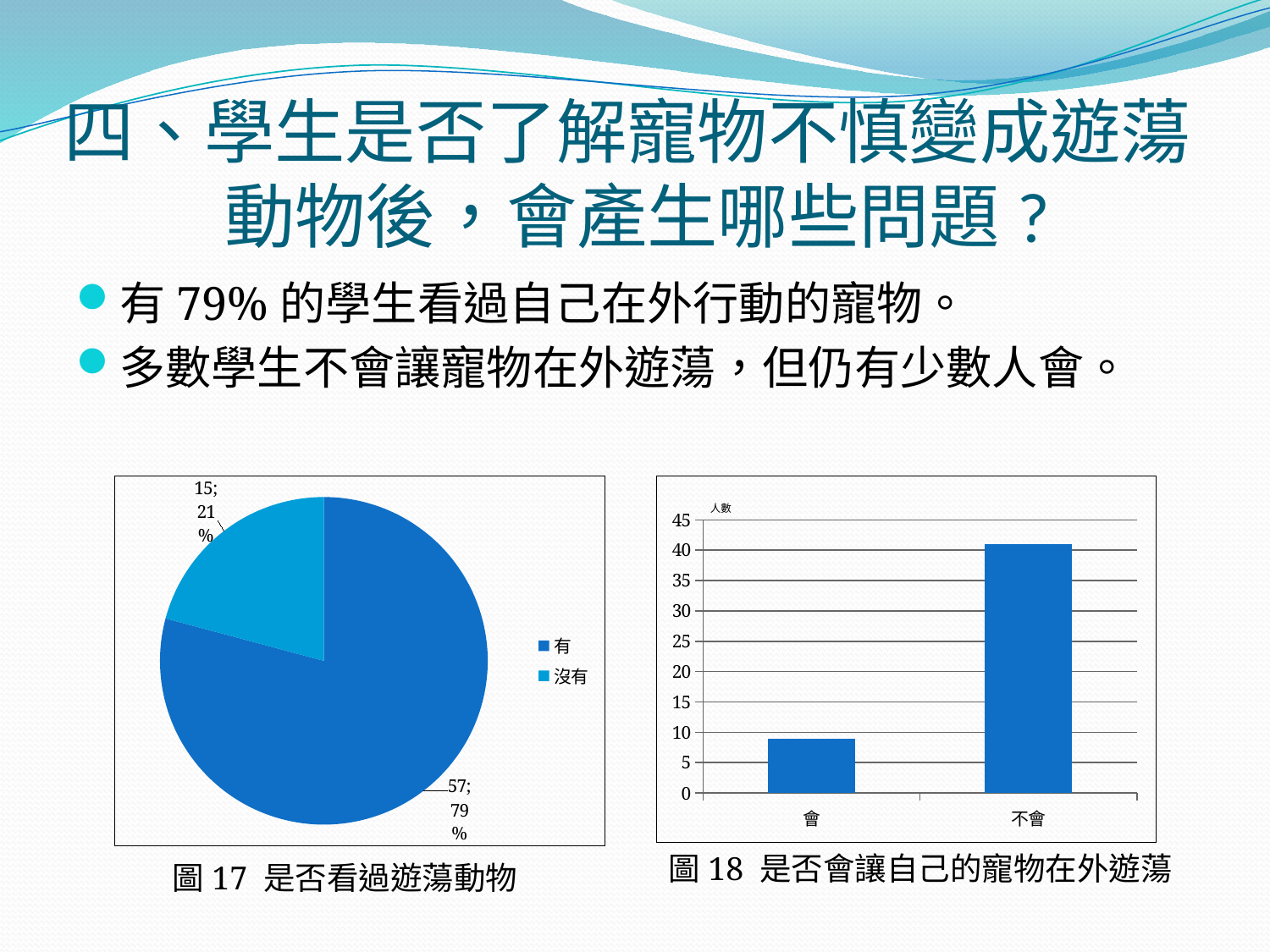
In the pie chart (圖 17 是否看過遊蕩動物), what count and percentage are shown for 有? 57; 79% In the bar chart (圖 18 是否會讓自己的寵物在外遊蕩), is the value for 會 greater or less than 10? less In the pie chart (圖 17 是否看過遊蕩動物), what count and percentage are shown for 沒有? 15; 21% How many entries does the legend of the pie chart (圖 17 是否看過遊蕩動物) list? 2 In the pie chart (圖 17 是否看過遊蕩動物), what is the difference in count between 有 and 沒有? 42 What is the label on the vertical axis of the bar chart (圖 18 是否會讓自己的寵物在外遊蕩)? 人數 In the bar chart (圖 18 是否會讓自己的寵物在外遊蕩), which category has the highest value? 不會 In the bar chart (圖 18 是否會讓自己的寵物在外遊蕩), is the value for 不會 greater or less than 40? greater What kind of chart is 圖 18 是否會讓自己的寵物在外遊蕩? Bar chart What kind of chart is 圖 17 是否看過遊蕩動物? Pie chart In the pie chart (圖 17 是否看過遊蕩動物), what share of the pie does 沒有 take? 21% In the pie chart (圖 17 是否看過遊蕩動物), which slice is larger, 有 or 沒有? 有